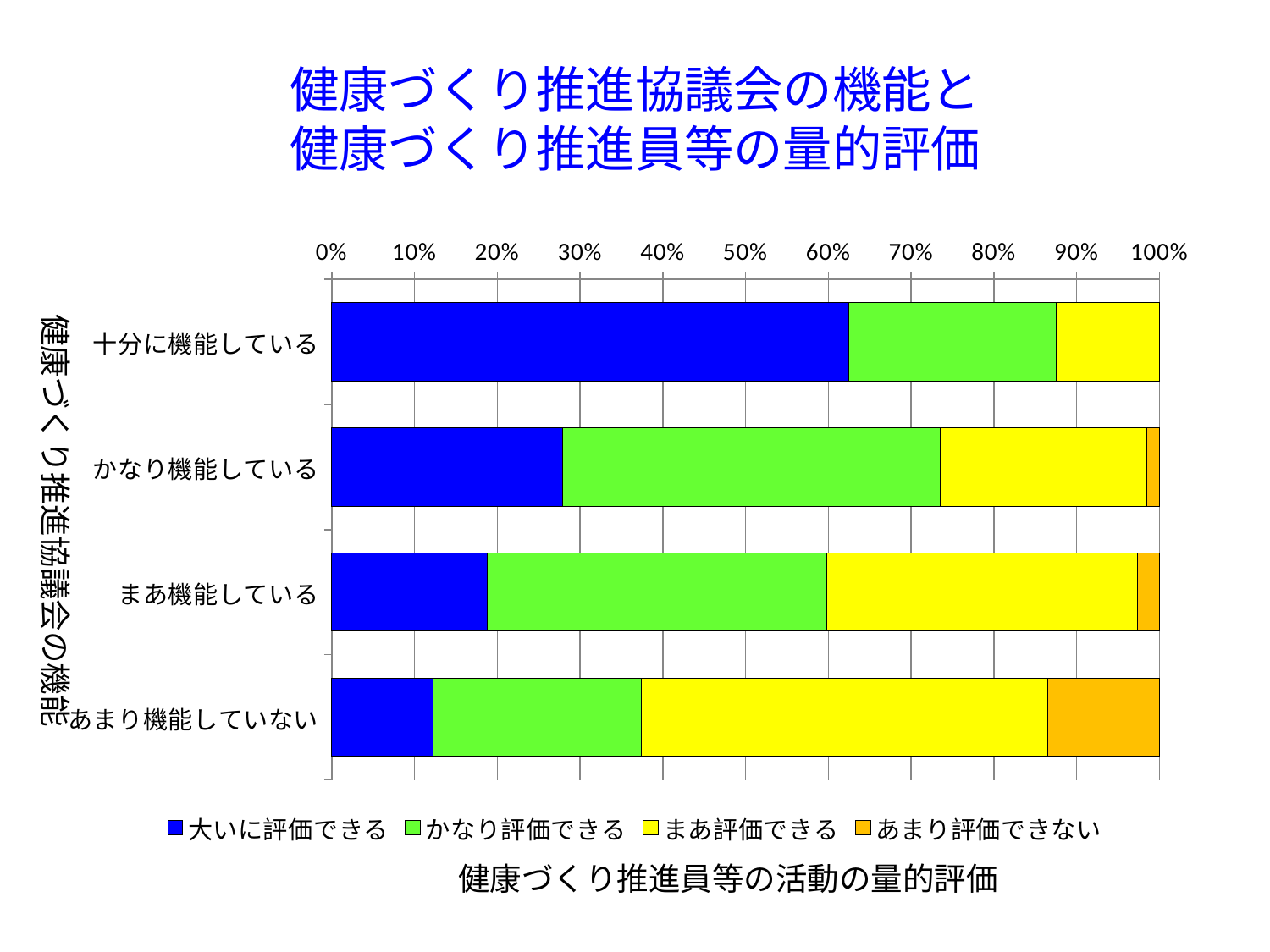
Which is larger: the 大いに評価できる segment for かなり機能している or for まあ機能している? かなり機能している Which colour represents まあ評価できる in the legend? Yellow Which category has the smallest 大いに評価できる segment? あまり機能していない How many categories are shown on the vertical axis of the chart? 4 Going from 十分に機能している down to あまり機能していない, does the 大いに評価できる share rise or fall? fall Is the 大いに評価できる value for あまり機能していない greater or less than 20%? less Which is larger: the かなり評価できる segment for 十分に機能している or for かなり機能している? かなり機能している Which category has the largest 大いに評価できる segment? 十分に機能している Which category has the largest あまり評価できない segment? あまり機能していない How many series does the legend list? 4 Is the 大いに評価できる value for 十分に機能している greater or less than 50%? greater What kind of chart is shown on the slide? Stacked bar chart